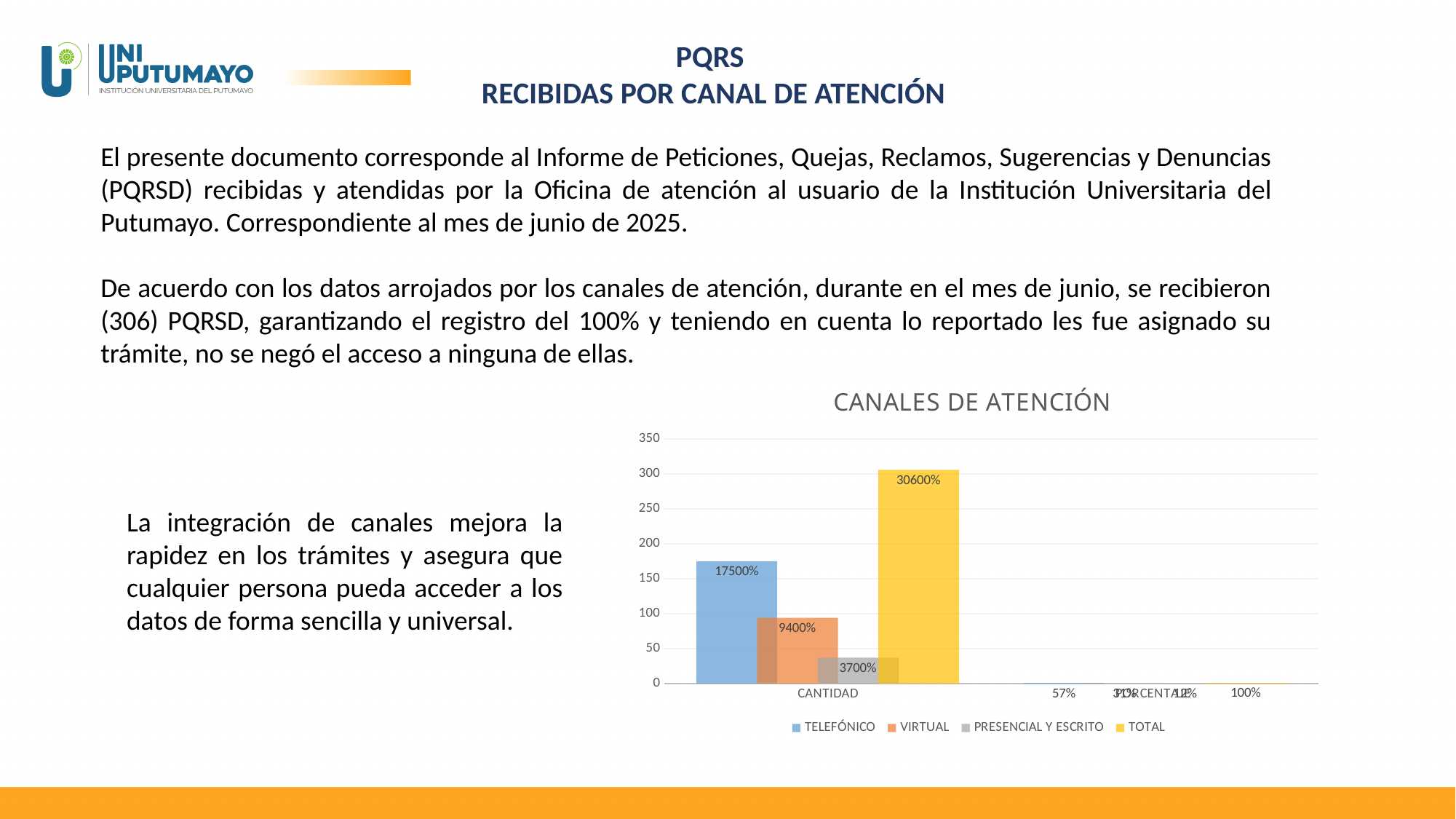
Which series has the shortest bar in the CANTIDAD group? PRESENCIAL Y ESCRITO What is the data label on the PRESENCIAL Y ESCRITO bar in the CANTIDAD group? 3700% In the CANTIDAD group, which bar is taller: TELEFÓNICO or VIRTUAL? TELEFÓNICO What kind of chart is shown on the slide? bar chart What is the data label on the TELEFÓNICO bar in the CANTIDAD group? 17500% What is the data label on the VIRTUAL bar in the CANTIDAD group? 9400% How many series does the legend of the CANALES DE ATENCIÓN chart list? 4 Which series has the tallest bar in the CANTIDAD group? TOTAL Is the TELEFÓNICO bar in the CANTIDAD group greater or less than 150 on the axis? greater What is the data label on the TOTAL bar in the CANTIDAD group? 30600% How many category groups are shown on the x axis of the chart? 2 What is the title of the chart? CANALES DE ATENCIÓN